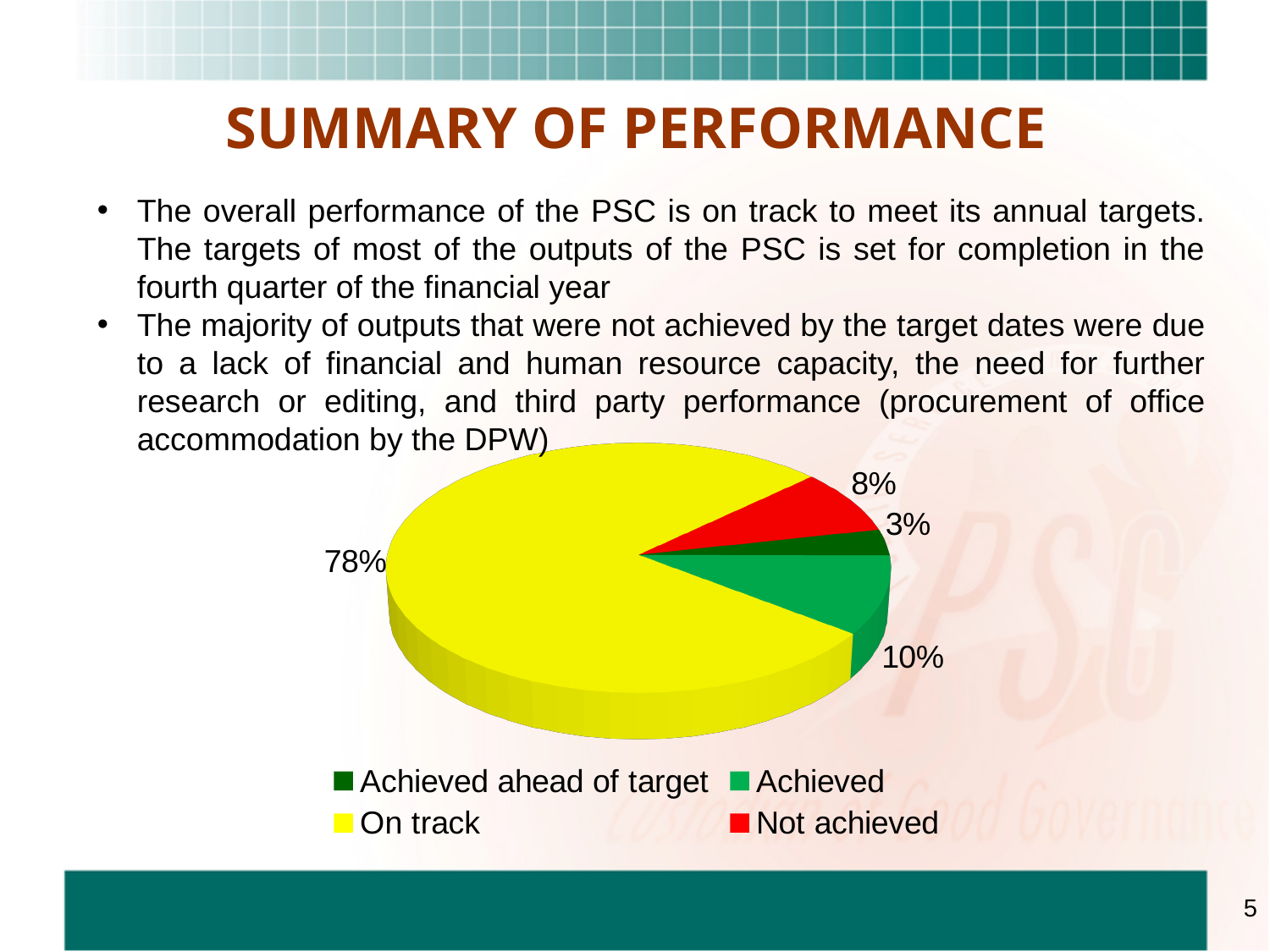
What percentage of outputs are shown as Achieved ahead of target? 3% Which category has the largest share of the pie? On track What is the difference in percentage points between the On track share and the Achieved share? 68 What percentage of outputs are shown as On track? 78% What percentage of outputs are shown as Achieved? 10% Which category has the smallest share of the pie? Achieved ahead of target Which is larger, the share for Achieved or the share for Not achieved? Achieved What colour represents the On track category? yellow What kind of chart is shown on the slide? pie chart What percentage of outputs are shown as Not achieved? 8% What colour represents the Not achieved category? red How many categories does the legend list? 4